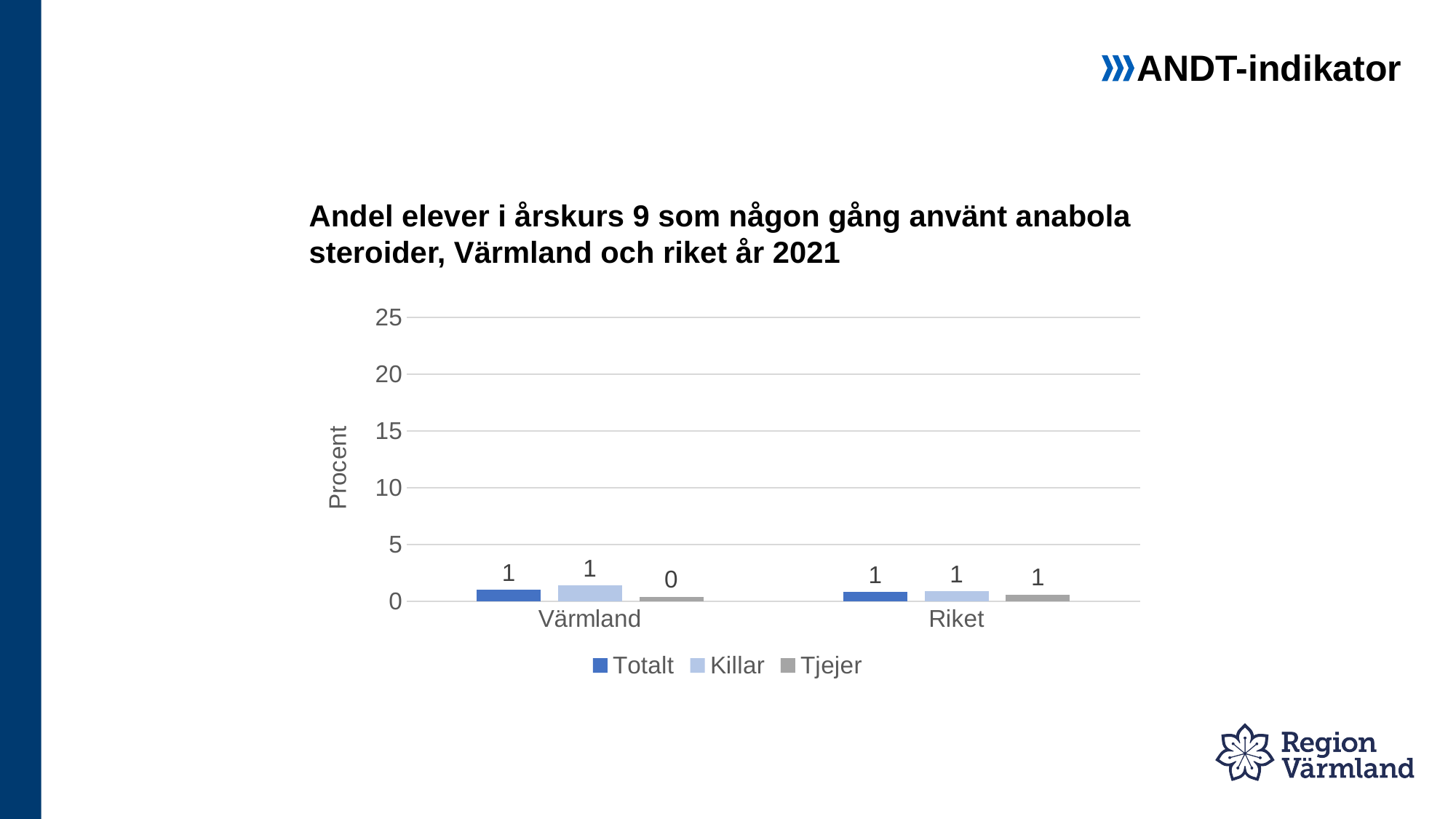
What is the difference between the Killar and Tjejer values for Värmland? 1 What is the value for Totalt in Värmland? 1 Which series has the lowest value for Värmland? Tjejer What is the value for Tjejer in Värmland? 0 What is the label of the y axis? Procent What kind of chart is shown on the slide? bar chart What is the value for Tjejer in Riket? 1 How many categories are shown on the x axis? 2 Is the value for Killar in Riket greater or less than 5? less How many series does the legend list? 3 What is the value for Killar in Riket? 1 Which is larger for Värmland, the Totalt value or the Tjejer value? Totalt